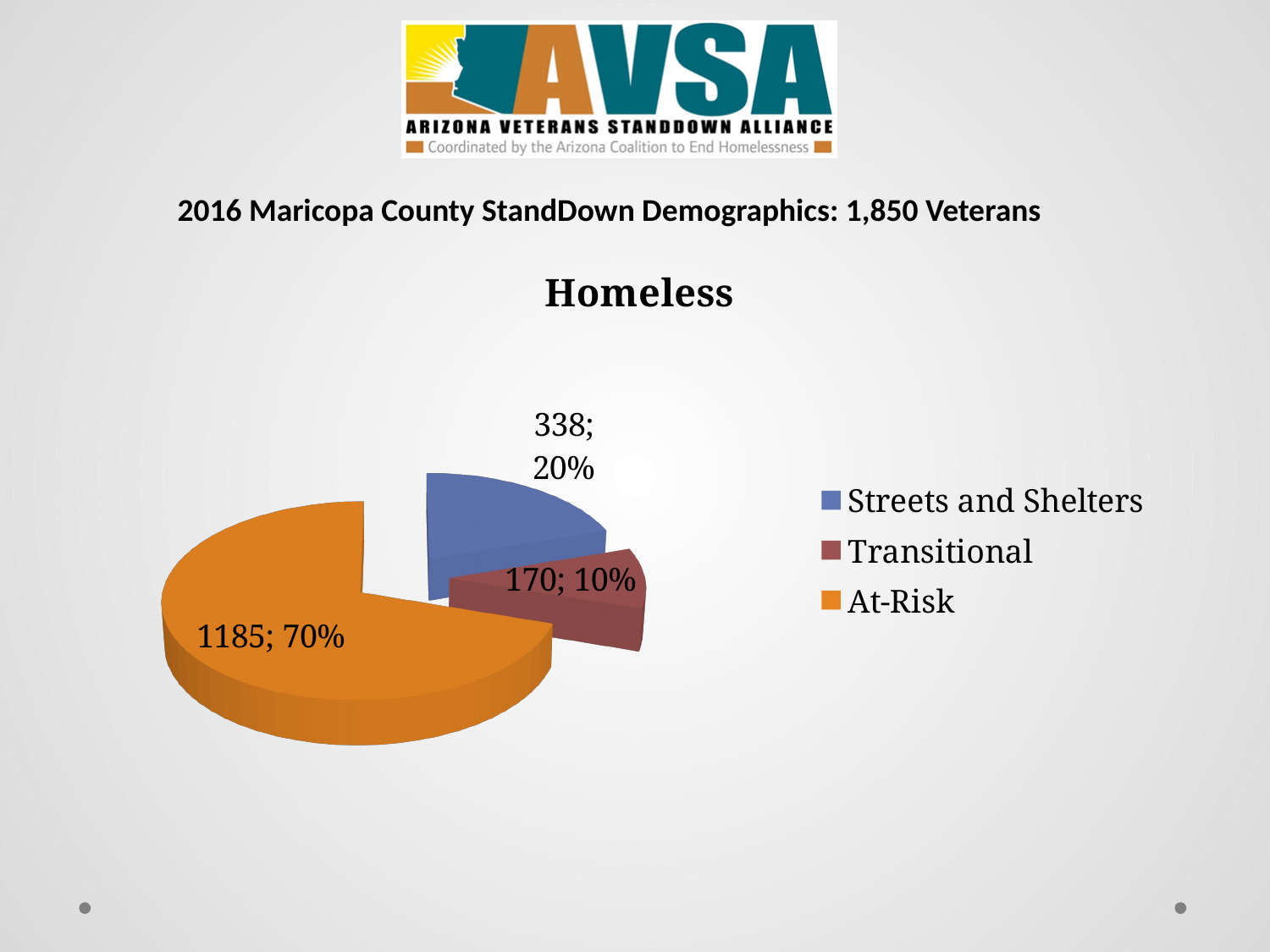
What share of the pie does At-Risk represent? 70% Which category has the largest slice? At-Risk What is the title of the chart? Homeless What is the value for At-Risk? 1185 What type of chart is shown on the slide? Pie chart How many entries does the legend list? 3 What share of the pie does Transitional represent? 10% What is the value for Transitional? 170 What is the difference between the At-Risk value and the Streets and Shelters value? 847 What is the value for Streets and Shelters? 338 How many slices does the pie chart have? 3 Which category has the smallest slice? Transitional